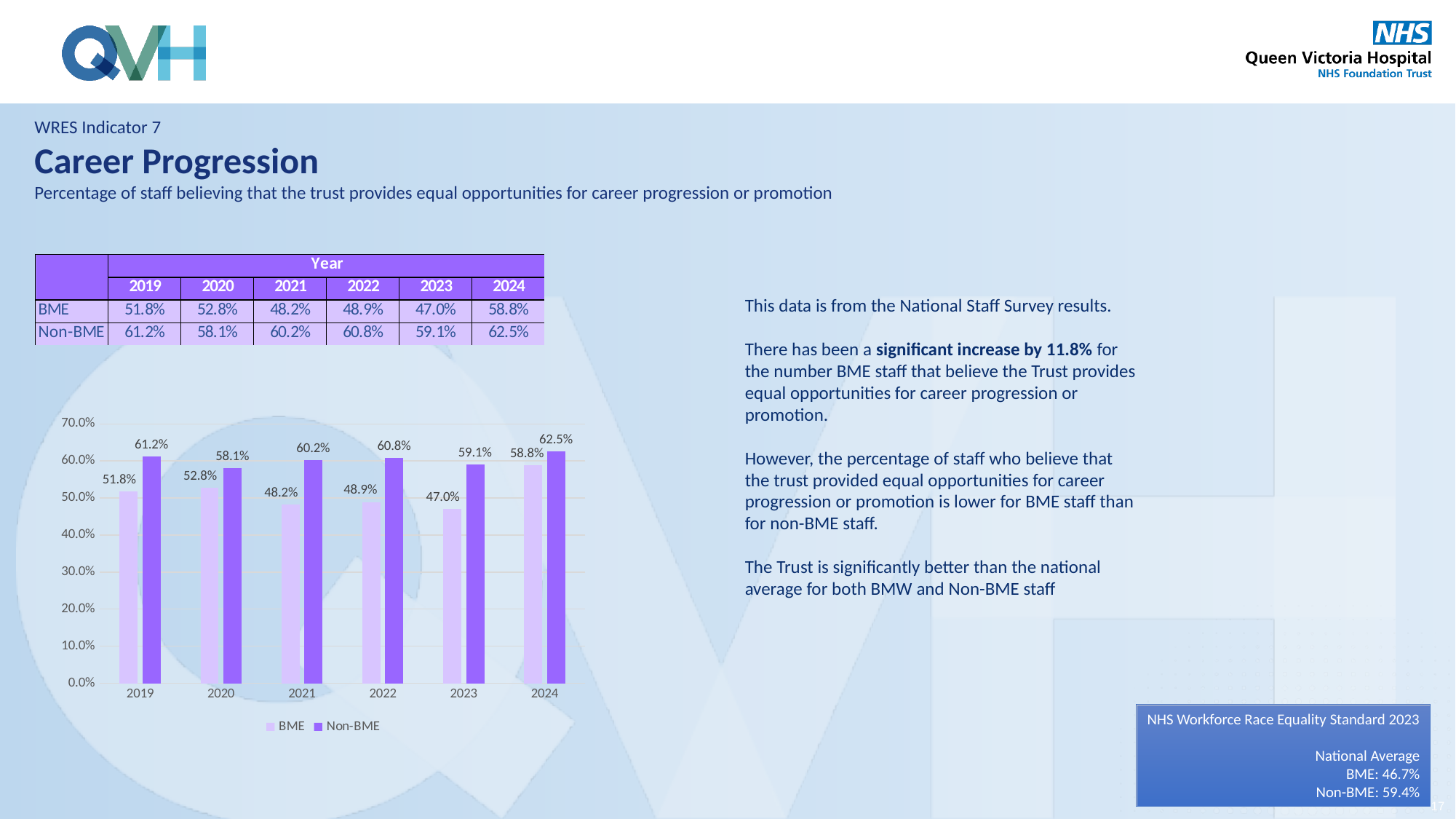
Which year has the lowest BME value in the chart? 2023 What is the Non-BME value for 2021 in the chart? 60.2% By how much did the BME value increase from 2023 to 2024? 11.8% How many series does the chart legend list? 2 Which is larger in 2022, the BME value or the Non-BME value? Non-BME What is the difference between the Non-BME and BME values for 2019? 9.4% What is the BME value for 2023 in the chart? 47.0% What kind of chart is shown on the slide? Bar chart How many years are shown on the x axis of the chart? 6 Which series is shown in the darker purple colour in the chart? Non-BME Which year has the highest Non-BME value in the chart? 2024 What is the BME value for 2024 in the chart? 58.8%